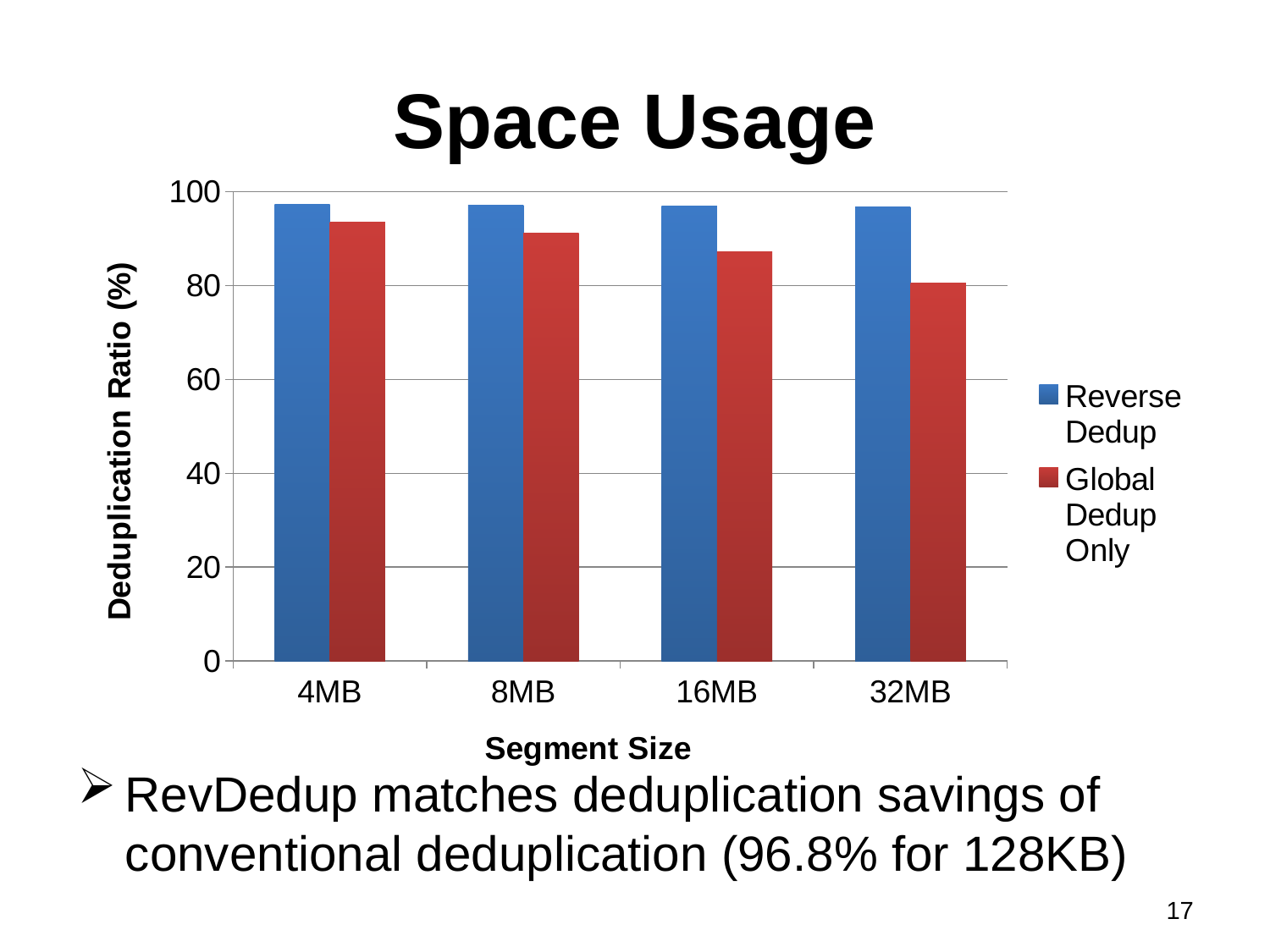
Does the Global Dedup Only deduplication ratio rise or fall as segment size increases from 4MB to 32MB? fall How many series does the chart's legend list? 2 Is the Reverse Dedup value for 4MB greater or less than 80? greater At 32MB, which series has the higher deduplication ratio, Reverse Dedup or Global Dedup Only? Reverse Dedup Is the Global Dedup Only value for 32MB greater or less than 90? less Is the Global Dedup Only value for 16MB greater or less than 80? greater What kind of chart is shown on the slide? bar chart For which segment size is the Global Dedup Only deduplication ratio lowest? 32MB How many segment sizes are shown on the x axis of the chart? 4 What is the title of the chart? Space Usage What is the label of the y axis? Deduplication Ratio (%) At 16MB, which series has the lower deduplication ratio, Reverse Dedup or Global Dedup Only? Global Dedup Only